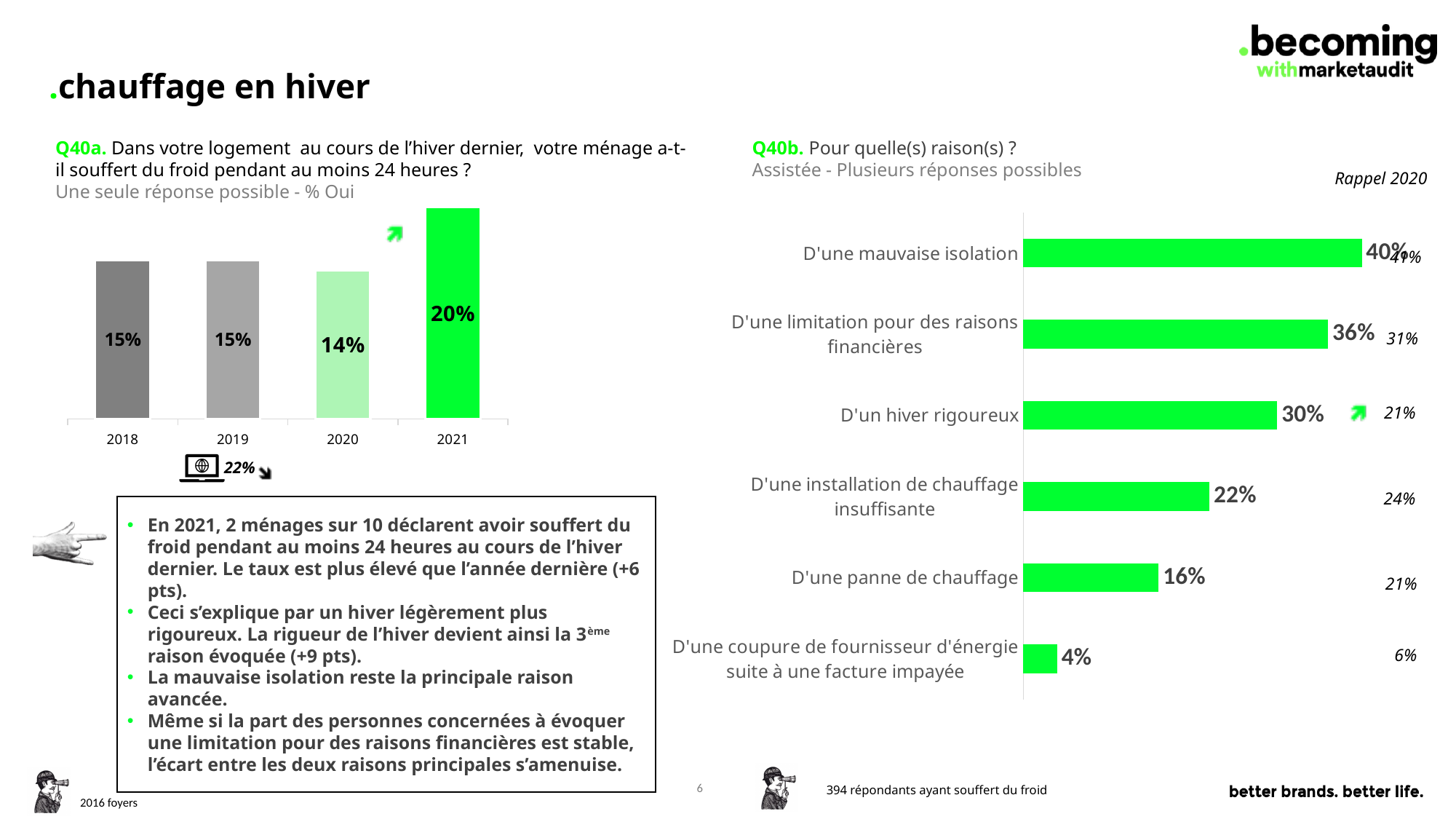
In the Q40a chart on the left, what is the difference between the 2021 and 2020 values? 6 points In the Q40b chart on the right, what is the value for 'D'une panne de chauffage'? 16% In the Q40a chart on the left, which year has the lowest value? 2020 In the Q40b chart on the right, which reason has the highest value? D'une mauvaise isolation In the Q40b chart on the right, which reason has the lowest value? D'une coupure de fournisseur d'énergie suite à une facture impayée In the Q40b chart on the right, what is the value for 'D'un hiver rigoureux'? 30% In the Q40a chart on the left, which year has the highest value? 2021 In the Q40a chart on the left, how many years are shown? 4 In the Q40b chart on the right, what is the difference between 'D'une mauvaise isolation' and 'D'une limitation pour des raisons financières'? 4 points What kind of chart is the Q40b chart on the right? Bar chart In the Q40a chart on the left, what is the value for 2021? 20% In the Q40a chart on the left, what is the value for 2020? 14%